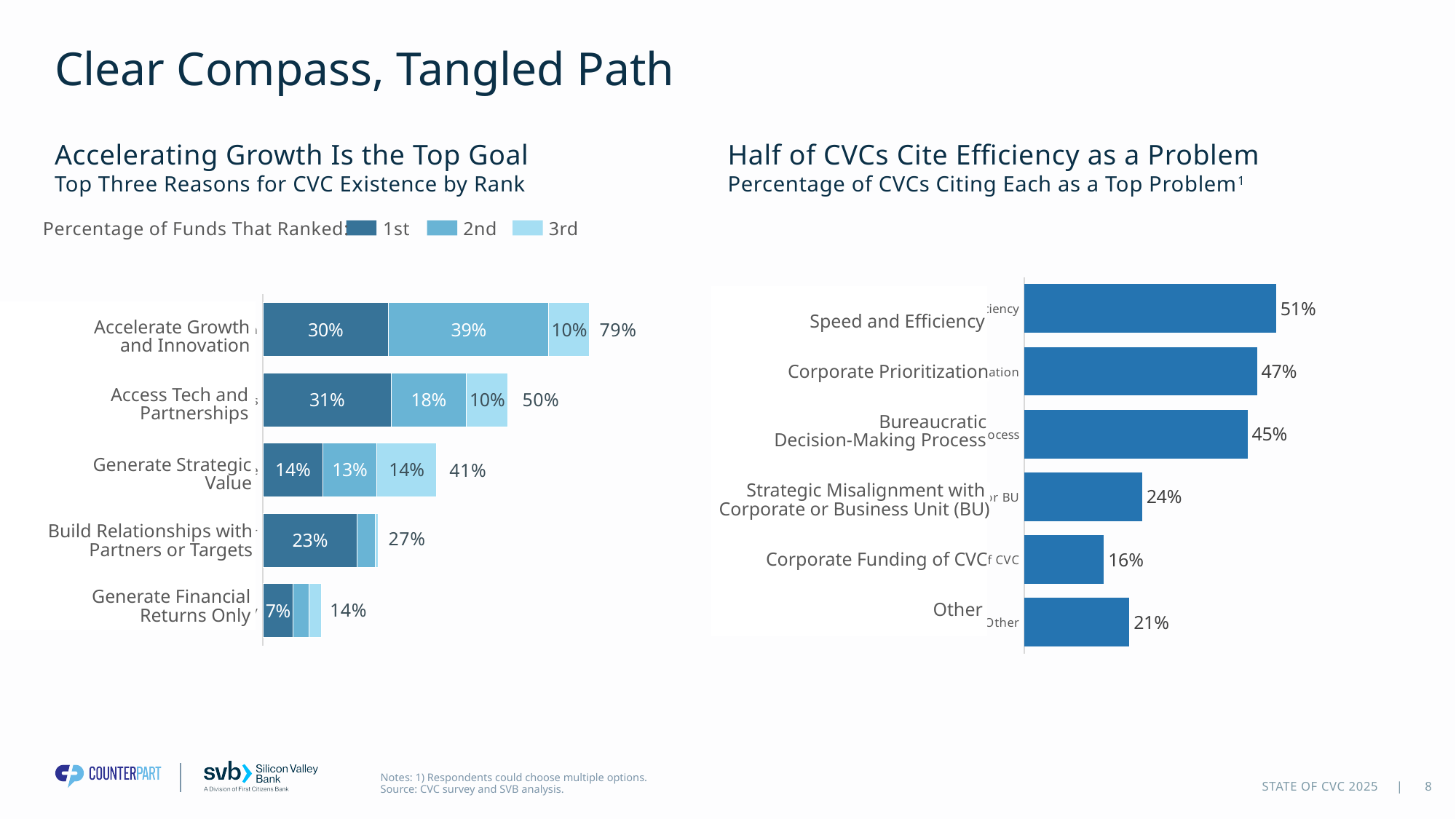
In the 'Accelerating Growth Is the Top Goal' chart, what percentage of funds ranked Accelerate Growth and Innovation 1st? 30% In the 'Accelerating Growth Is the Top Goal' chart, what is the total percentage for Access Tech and Partnerships? 50% In the 'Half of CVCs Cite Efficiency as a Problem' chart, which is larger: Other or Corporate Funding of CVC? Other In the 'Half of CVCs Cite Efficiency as a Problem' chart, what is the difference between Corporate Prioritization and Strategic Misalignment with Corporate or Business Unit (BU)? 23 percentage points In the 'Half of CVCs Cite Efficiency as a Problem' chart, how many problem categories are shown? 6 In the 'Half of CVCs Cite Efficiency as a Problem' chart, which problem has the highest percentage? Speed and Efficiency In the 'Accelerating Growth Is the Top Goal' chart, which reason has the lowest total percentage? Generate Financial Returns Only In the 'Half of CVCs Cite Efficiency as a Problem' chart, what percentage of CVCs cite Speed and Efficiency as a top problem? 51% In the 'Accelerating Growth Is the Top Goal' chart, what is the difference between the 2nd-rank share for Accelerate Growth and Innovation and the 2nd-rank share for Access Tech and Partnerships? 21 percentage points What kind of chart is the 'Accelerating Growth Is the Top Goal' chart? Stacked bar chart In the 'Accelerating Growth Is the Top Goal' chart, how many series does the legend list? 3 In the 'Half of CVCs Cite Efficiency as a Problem' chart, which problem has the lowest percentage? Corporate Funding of CVC